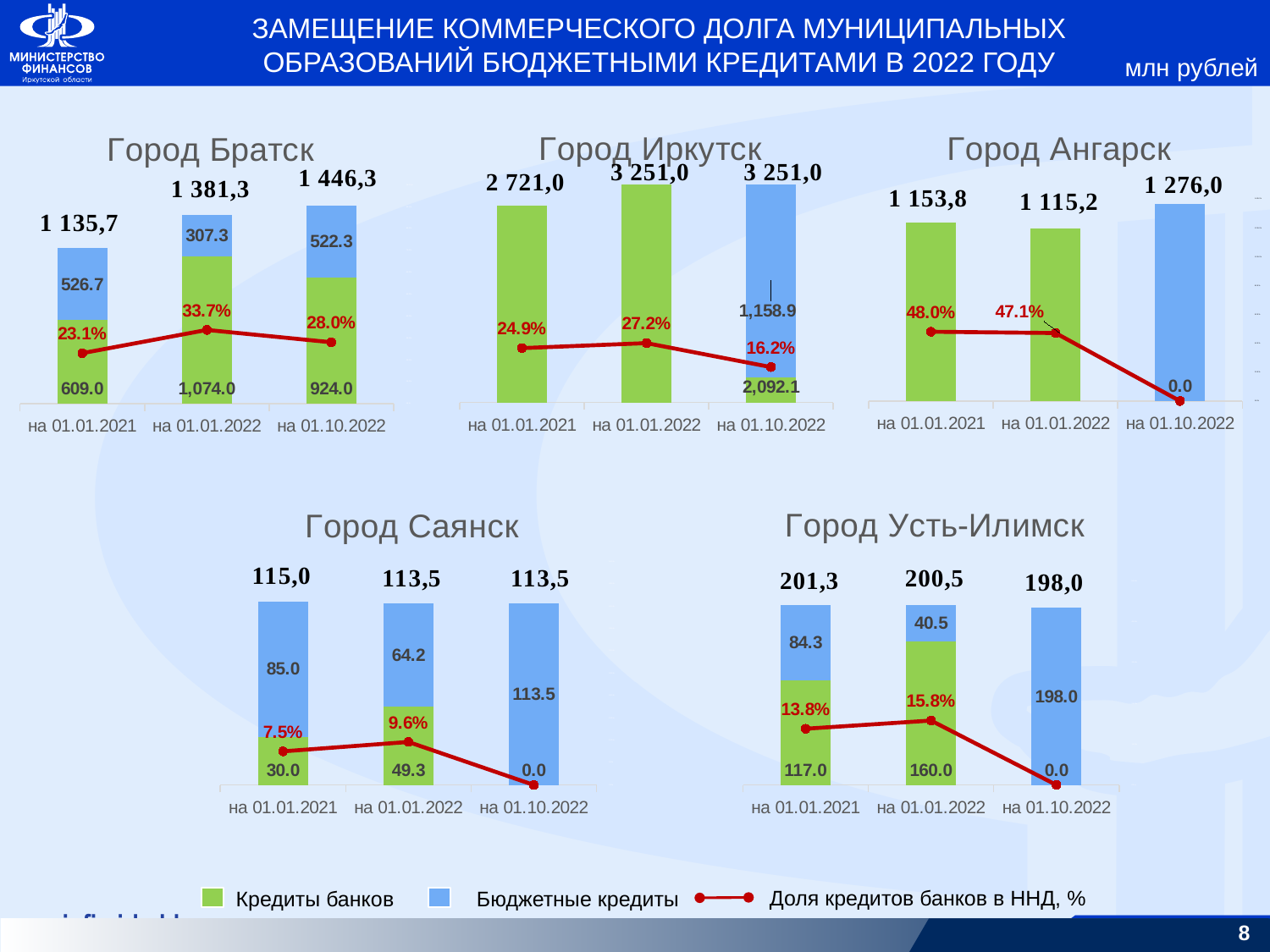
In the Город Усть-Илимск chart, how does the total of the stacked bars change from 01.01.2021 to 01.10.2022? It falls In the Город Усть-Илимск chart, what is the value of Бюджетные кредиты on 01.10.2022? 198.0 In the Город Саянск chart, which is larger: Кредиты банков on 01.01.2021 or on 01.01.2022? на 01.01.2022 In the Город Иркутск chart, on which date is the Доля кредитов банков в ННД, % line lowest? на 01.10.2022 In the Город Ангарск chart, what is the Доля кредитов банков в ННД, % value on 01.01.2022? 47.1% In the Город Братск chart, what is the Доля кредитов банков в ННД, % value on 01.01.2021? 23.1% How many series does the legend at the bottom of the slide list? 3 In the Город Ангарск chart, what is the total of the stacked bar for 01.01.2021? 1 153,8 In the Город Иркутск chart, what is the value of Бюджетные кредиты on 01.10.2022? 1,158.9 In the Город Братск chart, what is the value of Кредиты банков on 01.01.2022? 1,074.0 In the Город Братск chart, what is the total of the stacked bar for 01.10.2022? 1 446,3 In the Город Саянск chart, what is the difference between Бюджетные кредиты on 01.01.2021 and on 01.01.2022? 20.8